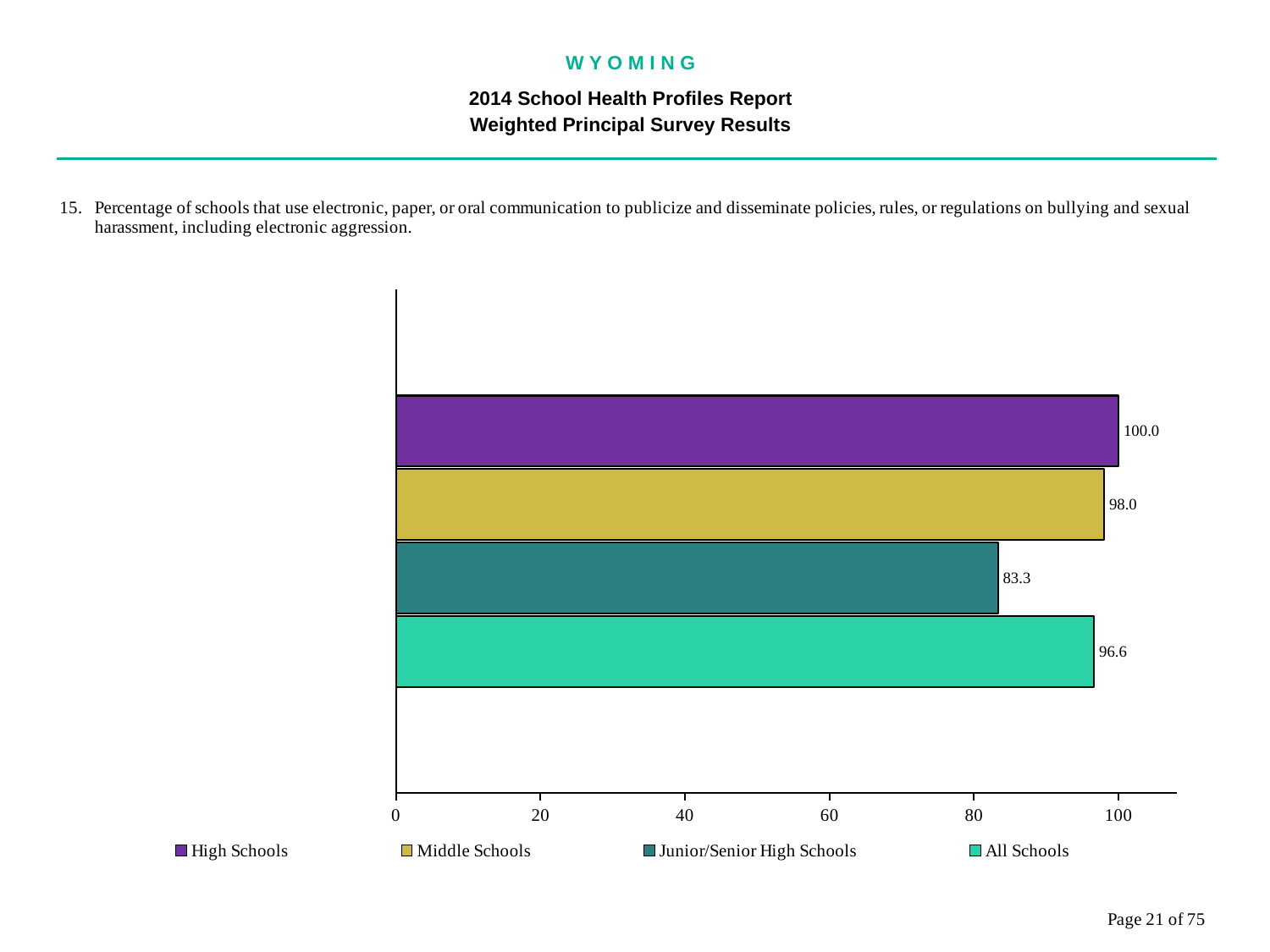
How many entries does the legend list? 4 What kind of chart is shown on the slide? Bar chart Which school type has the highest value? High Schools What is the value for High Schools? 100.0 What is the difference between the values for High Schools and Junior/Senior High Schools? 16.7 Which school type has the lowest value? Junior/Senior High Schools What is the value for All Schools? 96.6 What is the value for Middle Schools? 98.0 Which is larger, the value for Middle Schools or the value for Junior/Senior High Schools? Middle Schools What is the value for Junior/Senior High Schools? 83.3 What is the difference between the values for Middle Schools and All Schools? 1.4 How many bars are shown in the chart? 4